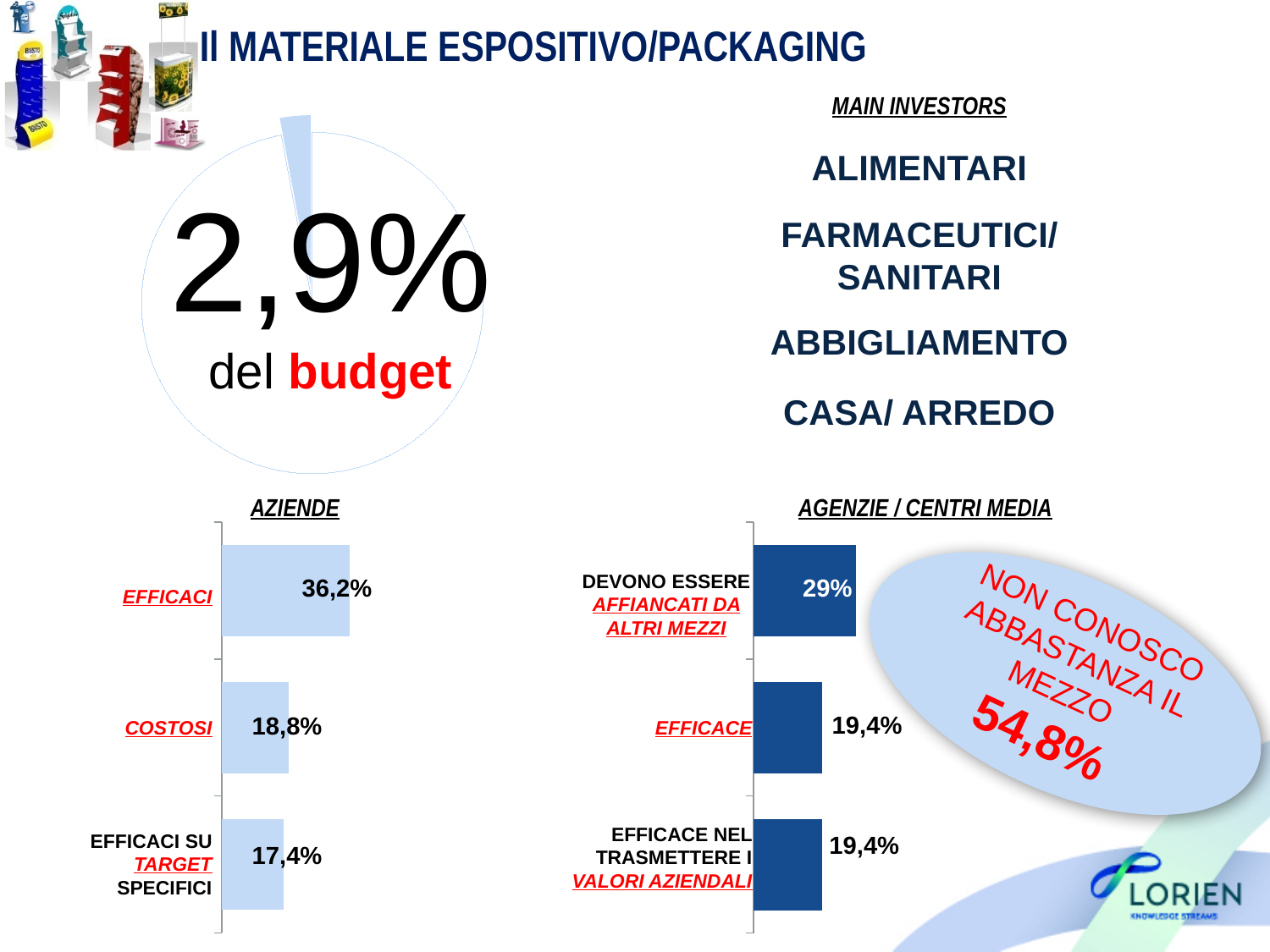
In the AZIENDE chart, what is the value for COSTOSI? 18,8% In the AGENZIE / CENTRI MEDIA chart, what is the value for EFFICACE? 19,4% In the pie chart at the top left, what share of the budget is shown? 2,9% In the AZIENDE chart, what is the difference between EFFICACI and COSTOSI? 17,4% In the AZIENDE chart, which category has the lowest value? EFFICACI SU TARGET SPECIFICI What kind of chart is the AZIENDE chart? Bar chart In the AZIENDE chart, what is the value for EFFICACI SU TARGET SPECIFICI? 17,4% In the AGENZIE / CENTRI MEDIA chart, how many categories are shown? 3 In the AGENZIE / CENTRI MEDIA chart, what is the value for DEVONO ESSERE AFFIANCATI DA ALTRI MEZZI? 29% In the AZIENDE chart, which category has the highest value? EFFICACI In the AGENZIE / CENTRI MEDIA chart, which category has the highest value? DEVONO ESSERE AFFIANCATI DA ALTRI MEZZI In the AZIENDE chart, what is the value for EFFICACI? 36,2%